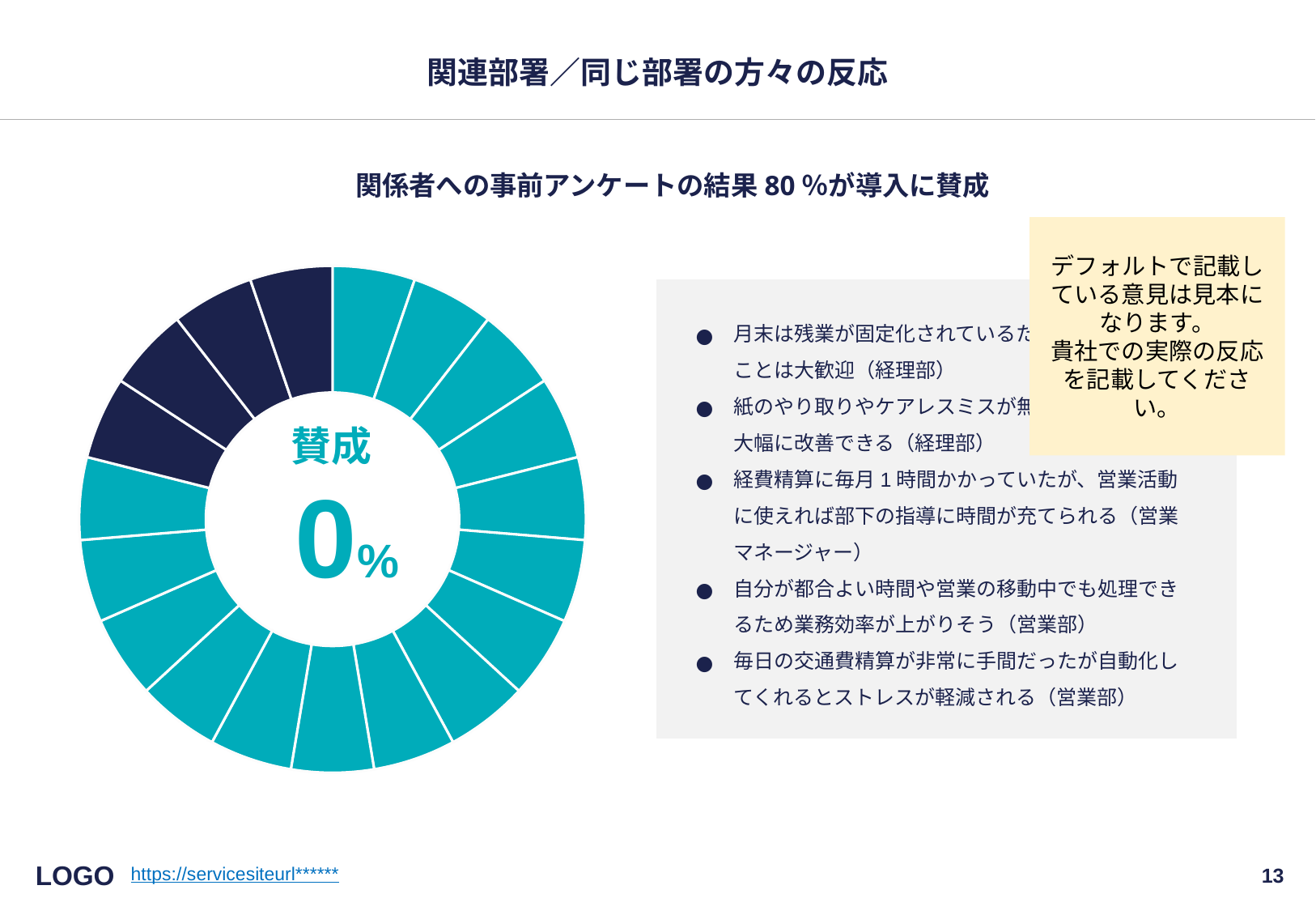
According to the heading above the chart, what percentage of respondents were in favour of the introduction (導入に賛成)? 80 % Which two colours are used for the segments of the donut chart? Teal and dark navy How many segments of the donut chart are coloured dark navy? 4 What kind of chart is shown on the slide? Pie (donut) chart Are there more teal segments or more dark navy segments in the donut chart? Teal How many segments does the donut chart have in total? 19 What percentage value is printed in the centre of the donut chart? 0% What word is printed above the percentage in the centre of the donut chart? 賛成 How many segments of the donut chart are coloured teal? 15